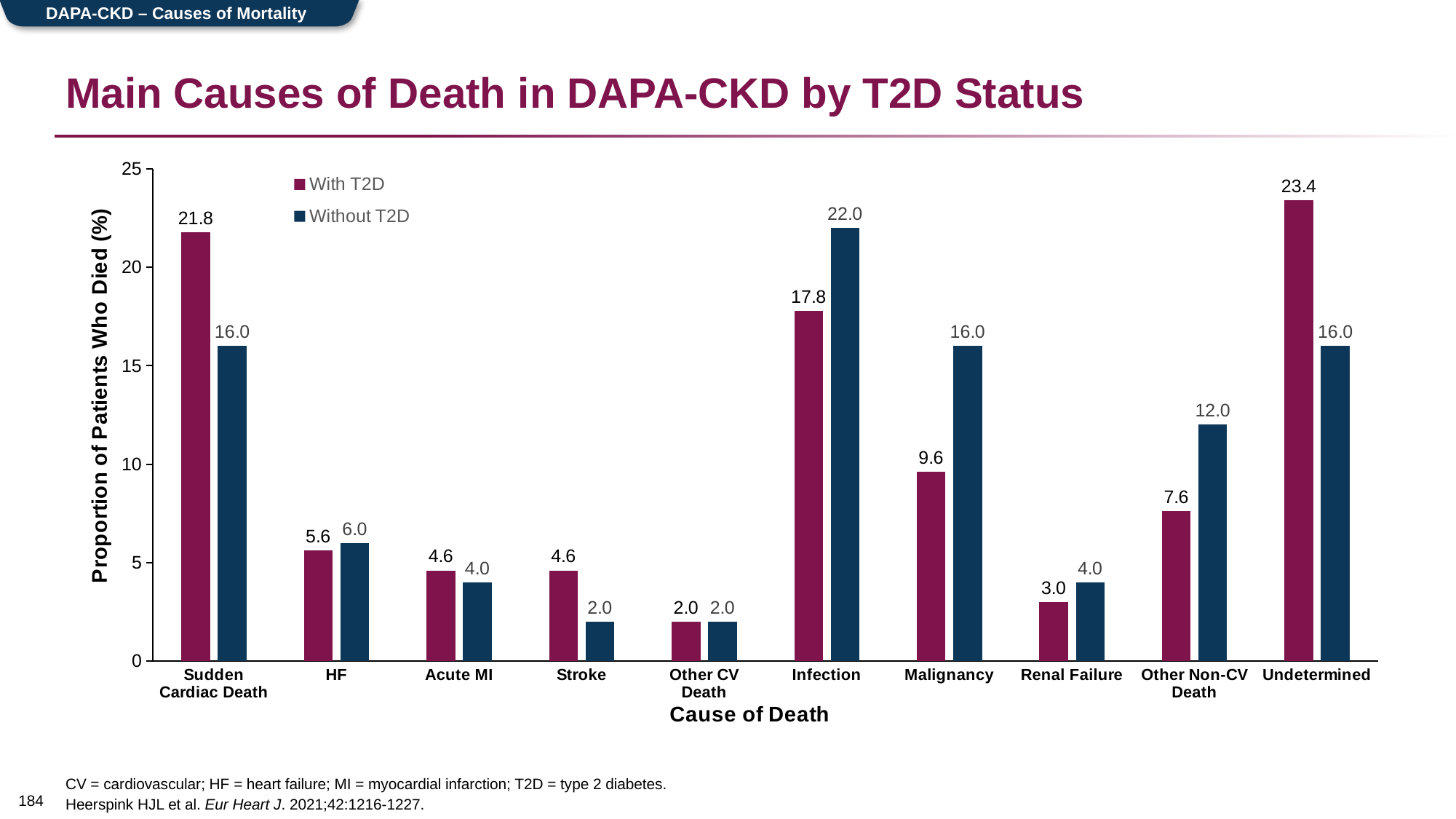
What is the value for Other Non-CV Death in the With T2D series? 7.6 Which cause of death has the lowest value in the Without T2D series? Stroke and Other CV Death (both 2.0) What kind of chart is shown on the slide? Bar chart What is the value for Infection in the Without T2D series? 22.0 How many causes of death are shown on the x axis? 10 For Malignancy, which series has the larger value, With T2D or Without T2D? Without T2D How many series does the legend list? 2 What is the value for Sudden Cardiac Death in the With T2D series? 21.8 Is the value for Infection in the With T2D series greater or less than 15? greater Which cause of death has the highest value in the With T2D series? Undetermined What is the label of the y axis? Proportion of Patients Who Died (%) What is the difference between the With T2D and Without T2D values for Sudden Cardiac Death? 5.8